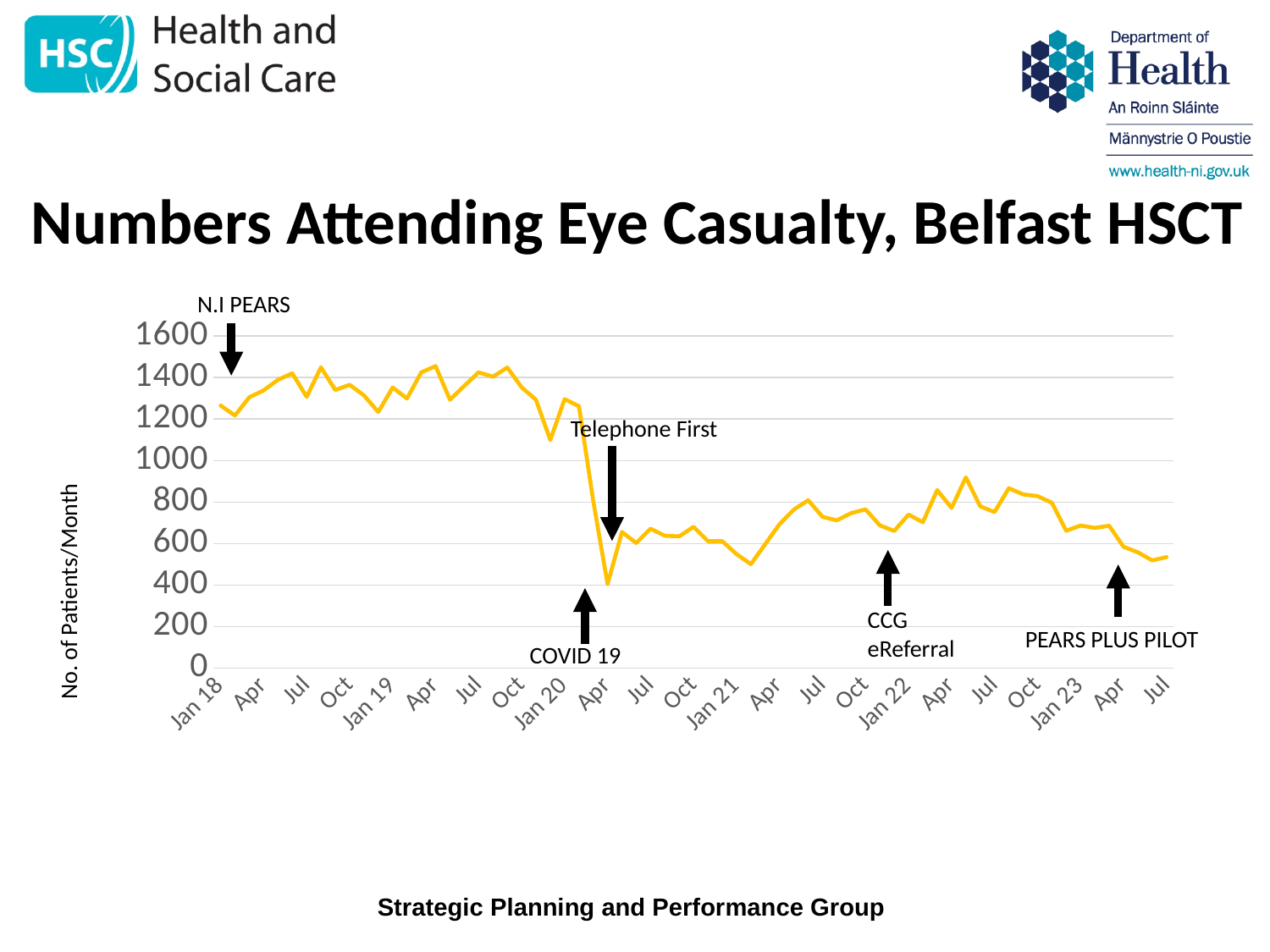
Is the value for Apr 19 greater or less than 1200? greater Which is larger, the value for Jan 18 or the value for Jul 23? Jan 18 Is the value for Jul 23 greater or less than 800? less Is the value for Apr 20 greater or less than 600? less Overall, do the values rise or fall from Jan 18 to Jul 23? fall Which month has the lowest value on the chart? Apr 20 Which is larger, the value for Apr 19 or the value for Apr 20? Apr 19 What is the title of the chart? Numbers Attending Eye Casualty, Belfast HSCT What kind of chart is shown on the slide? Line chart What is the label on the vertical axis of the chart? No. of Patients/Month